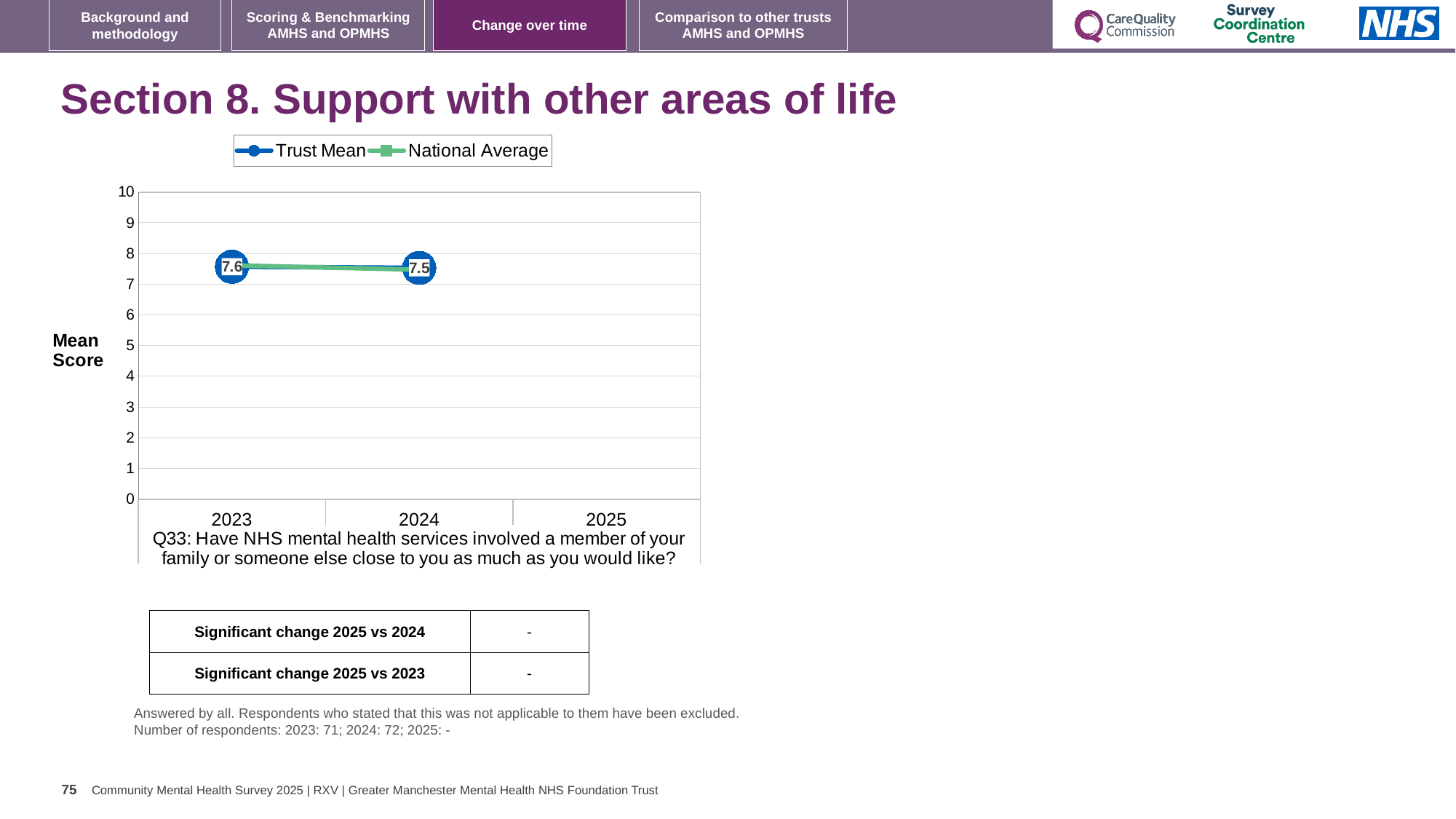
What kind of chart is shown on the slide? line chart What is the Trust Mean score for 2023? 7.6 Does the Trust Mean rise or fall from 2023 to 2024? fall What is the Trust Mean score for 2024? 7.5 Which year on the x axis has no plotted Trust Mean value? 2025 Which year has the higher Trust Mean score, 2023 or 2024? 2023 What are the two series named in the legend? Trust Mean and National Average How many series does the legend list? 2 How many years are shown on the x axis? 3 Is the Trust Mean score for 2024 greater or less than 5? greater What is the difference between the Trust Mean scores for 2023 and 2024? 0.1